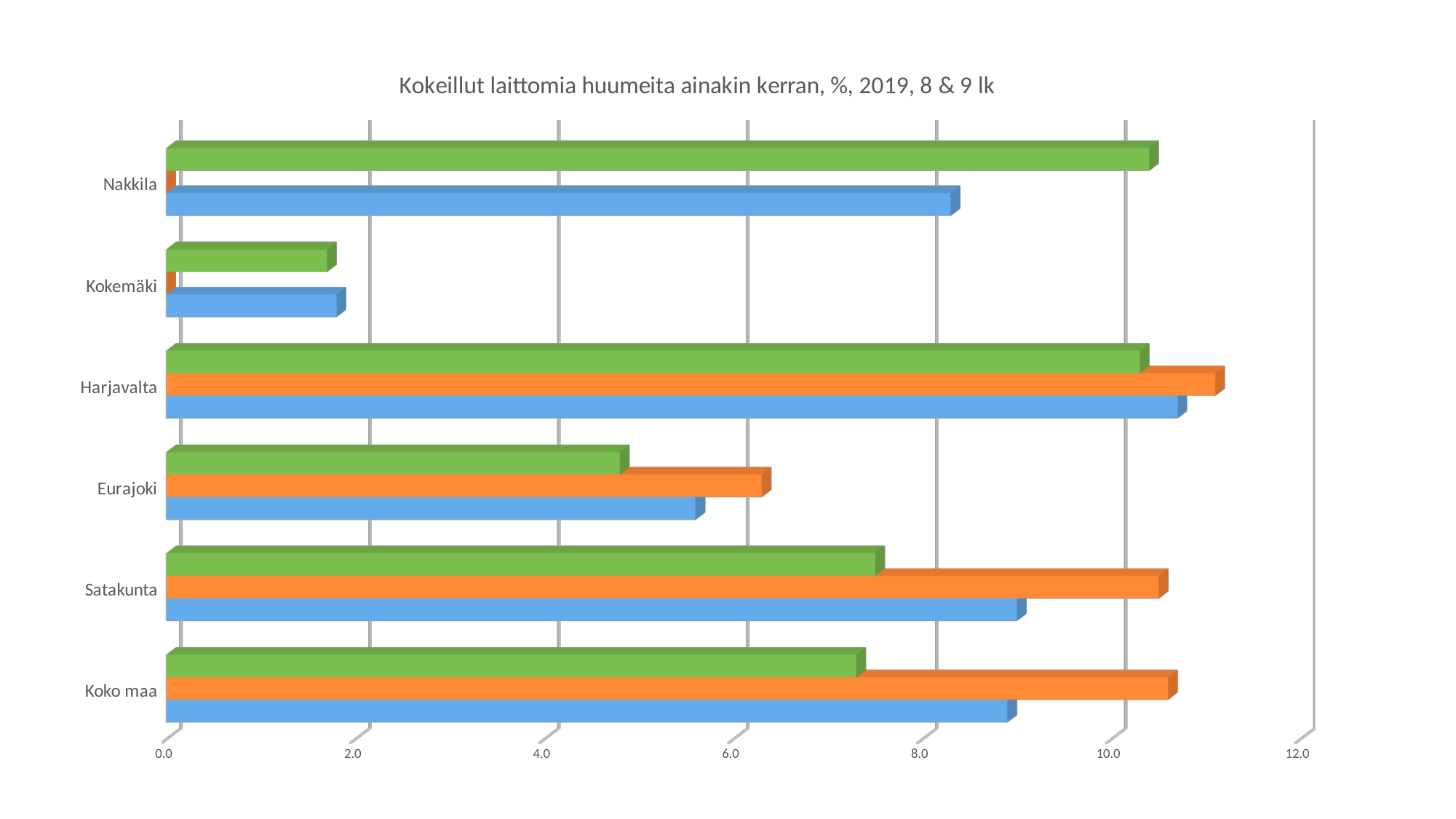
For Nakkila, which is larger: the green bar or the blue bar? The green bar Is the green bar for Nakkila greater or less than 10.0? greater Is the orange bar for Harjavalta greater or less than 10.0? greater Is the orange bar for Koko maa greater or less than 10.0? greater For Eurajoki, which is larger: the orange bar or the green bar? The orange bar Which category has the longest orange bar? Harjavalta What is the title of the chart? Kokeillut laittomia huumeita ainakin kerran, %, 2019, 8 & 9 lk How many categories are shown on the vertical axis of the chart? 6 What kind of chart is shown on the slide? Bar chart Which category has the shortest blue bar? Kokemäki